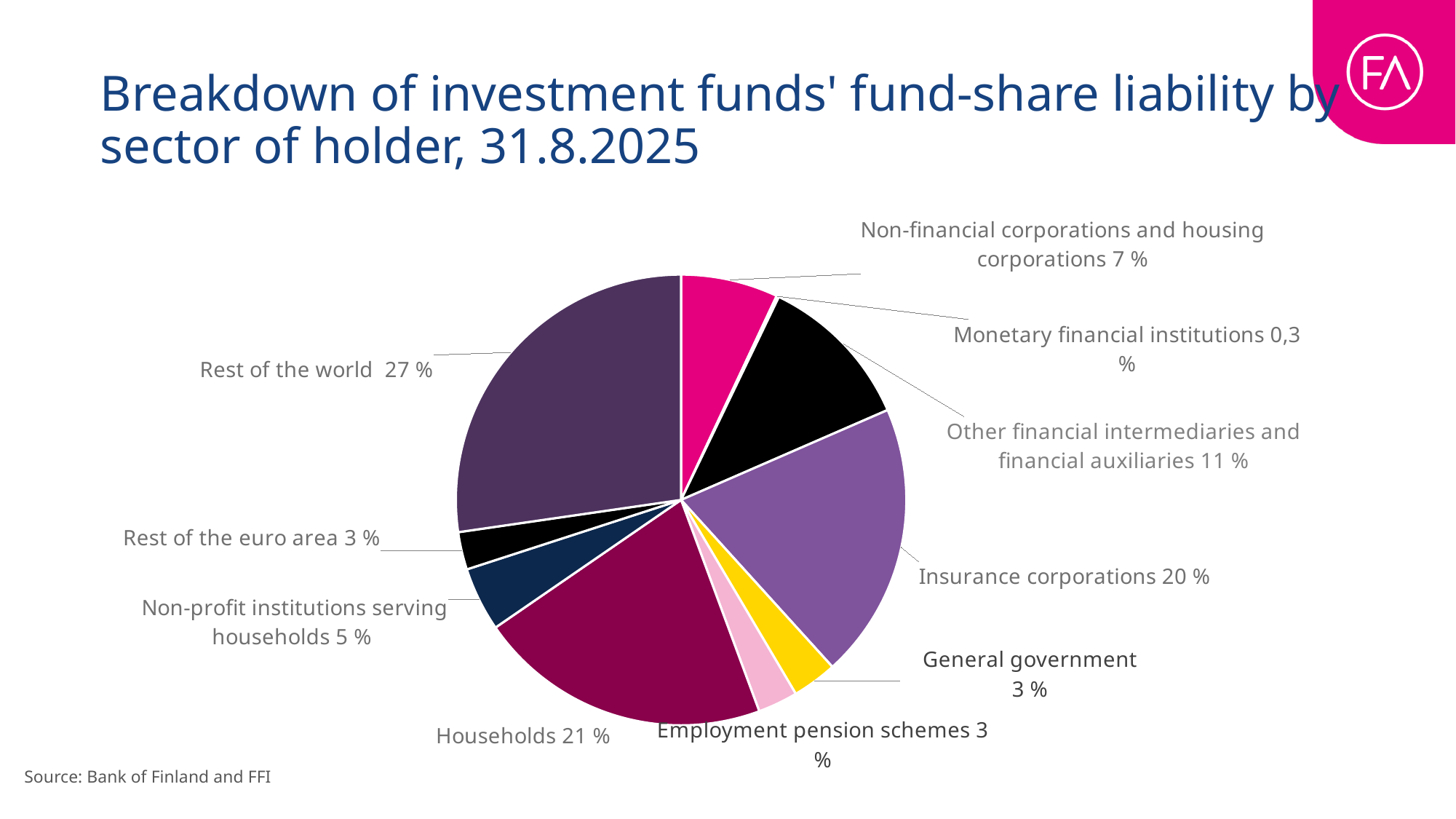
What kind of chart is shown on the slide? Pie chart Which sector holds the largest share of the fund-share liability? Rest of the world What is the difference in percentage points between the Rest of the world share and the Households share? 6 % What share is held by Other financial intermediaries and financial auxiliaries? 11 % What share is held by Households? 21 % How many sectors are shown in the pie chart? 10 What share is held by Monetary financial institutions? 0,3 % What is the title of the chart on the slide? Breakdown of investment funds' fund-share liability by sector of holder, 31.8.2025 Which holds a larger share, Insurance corporations or Non-financial corporations and housing corporations? Insurance corporations Which sector holds the smallest share of the fund-share liability? Monetary financial institutions What share of the fund-share liability is held by Rest of the world? 27 % What share is held by Insurance corporations? 20 %